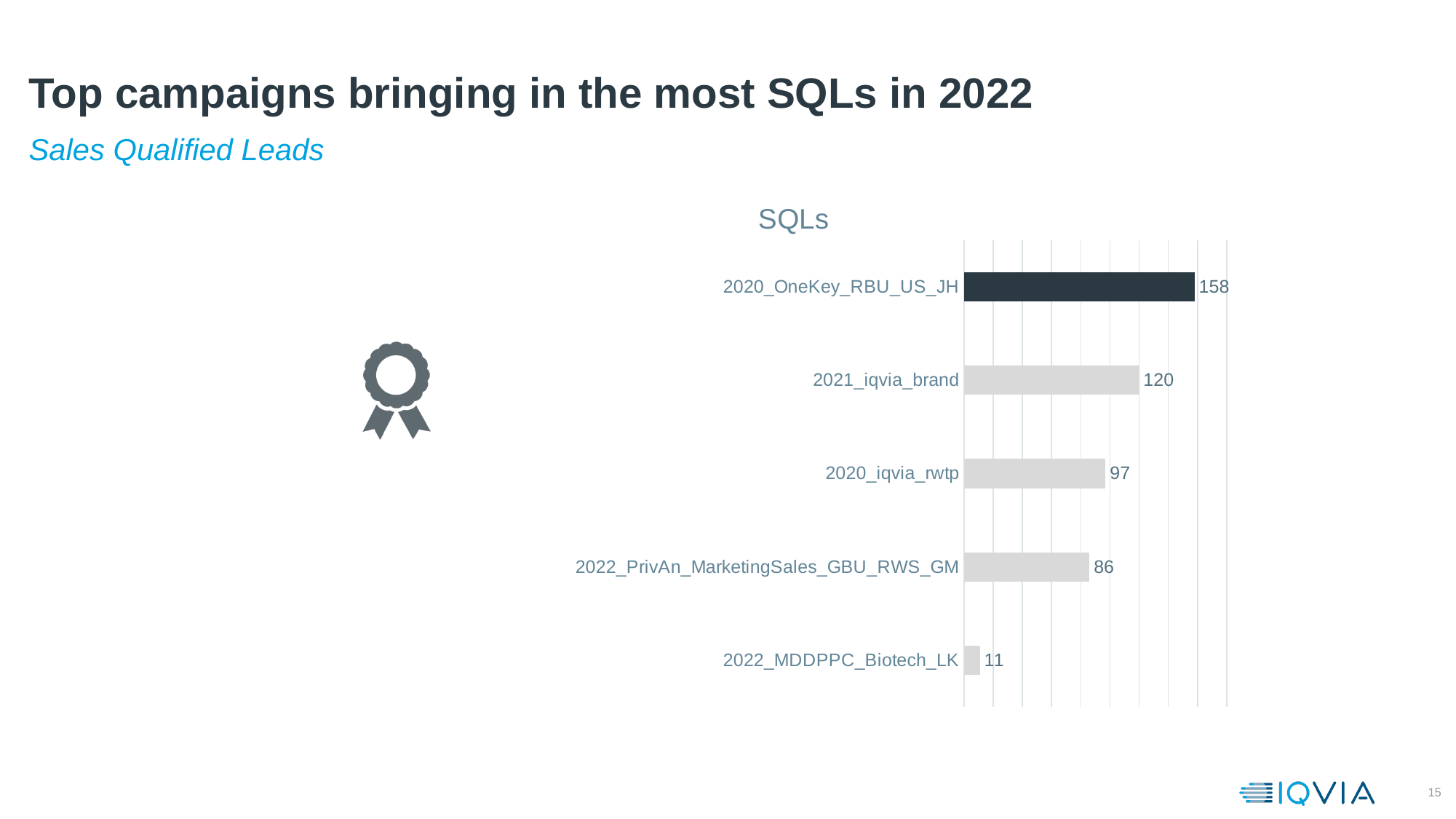
Which campaign has the lowest number of SQLs? 2022_MDDPPC_Biotech_LK How many campaigns are shown in the chart? 5 Which campaign has the highest number of SQLs? 2020_OneKey_RBU_US_JH What is the SQLs value for 2020_OneKey_RBU_US_JH? 158 What is the SQLs value for 2022_PrivAn_MarketingSales_GBU_RWS_GM? 86 What type of chart is shown on the slide? Bar chart What is the SQLs value for 2020_iqvia_rwtp? 97 What is the SQLs value for 2021_iqvia_brand? 120 What is the title of the chart? SQLs Which has more SQLs, 2020_iqvia_rwtp or 2022_PrivAn_MarketingSales_GBU_RWS_GM? 2020_iqvia_rwtp What is the SQLs value for 2022_MDDPPC_Biotech_LK? 11 What is the difference in SQLs between 2020_OneKey_RBU_US_JH and 2021_iqvia_brand? 38